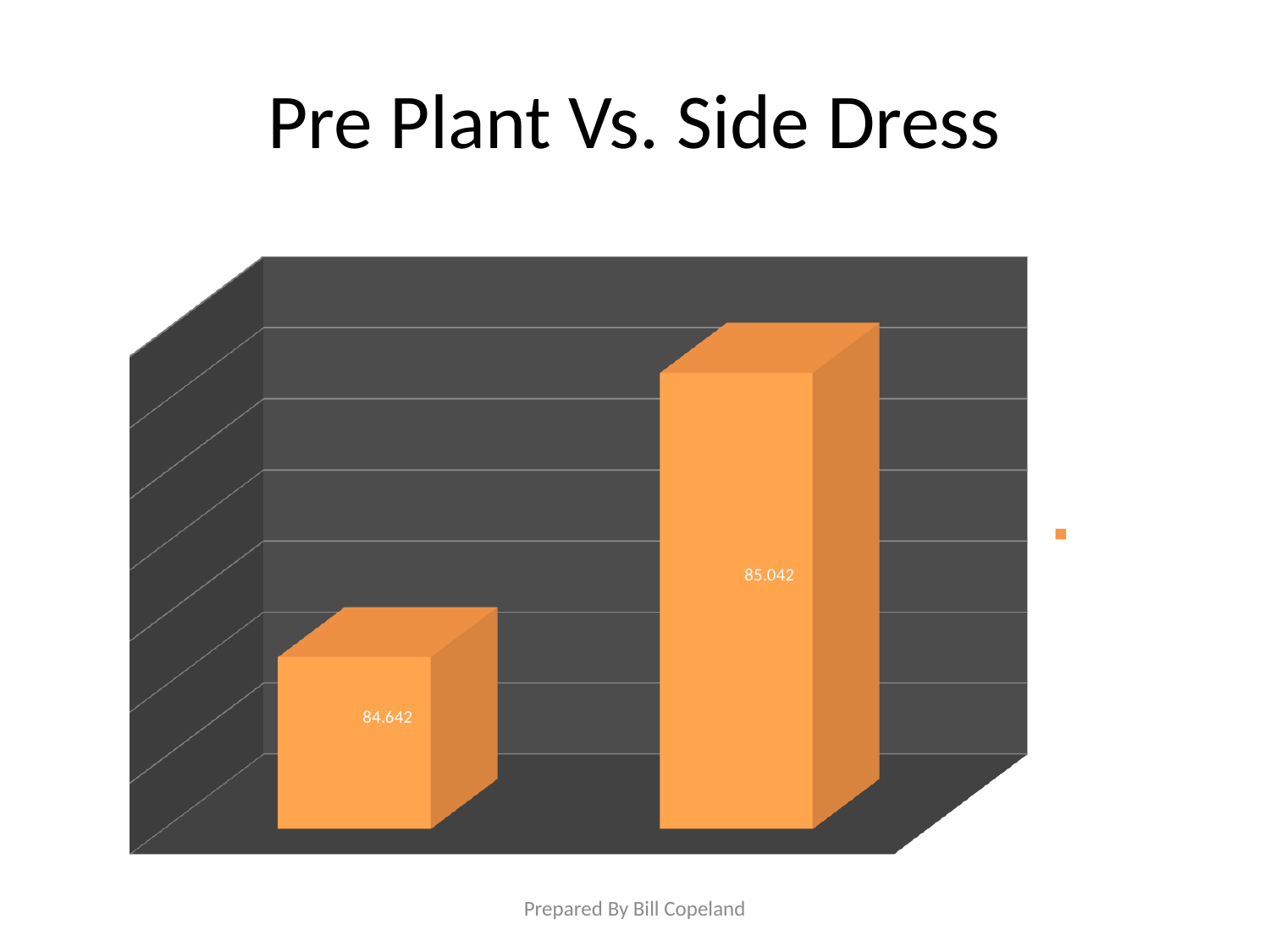
Which bar has the lowest value, the left or the right? left What kind of chart is shown on the slide? bar chart How many entries does the legend show? 1 Is the left bar's value larger or smaller than the right bar's value? smaller Do the bar values rise or fall from left to right? rise What is the title of the chart on the slide? Pre Plant Vs. Side Dress How many bars are plotted in the chart? 2 What is the difference between the right bar's value and the left bar's value? 0.400 Which bar has the highest value, the left or the right? right What colour are the bars in the chart? orange What value is labelled on the right bar? 85.042 What value is labelled on the left bar? 84.642